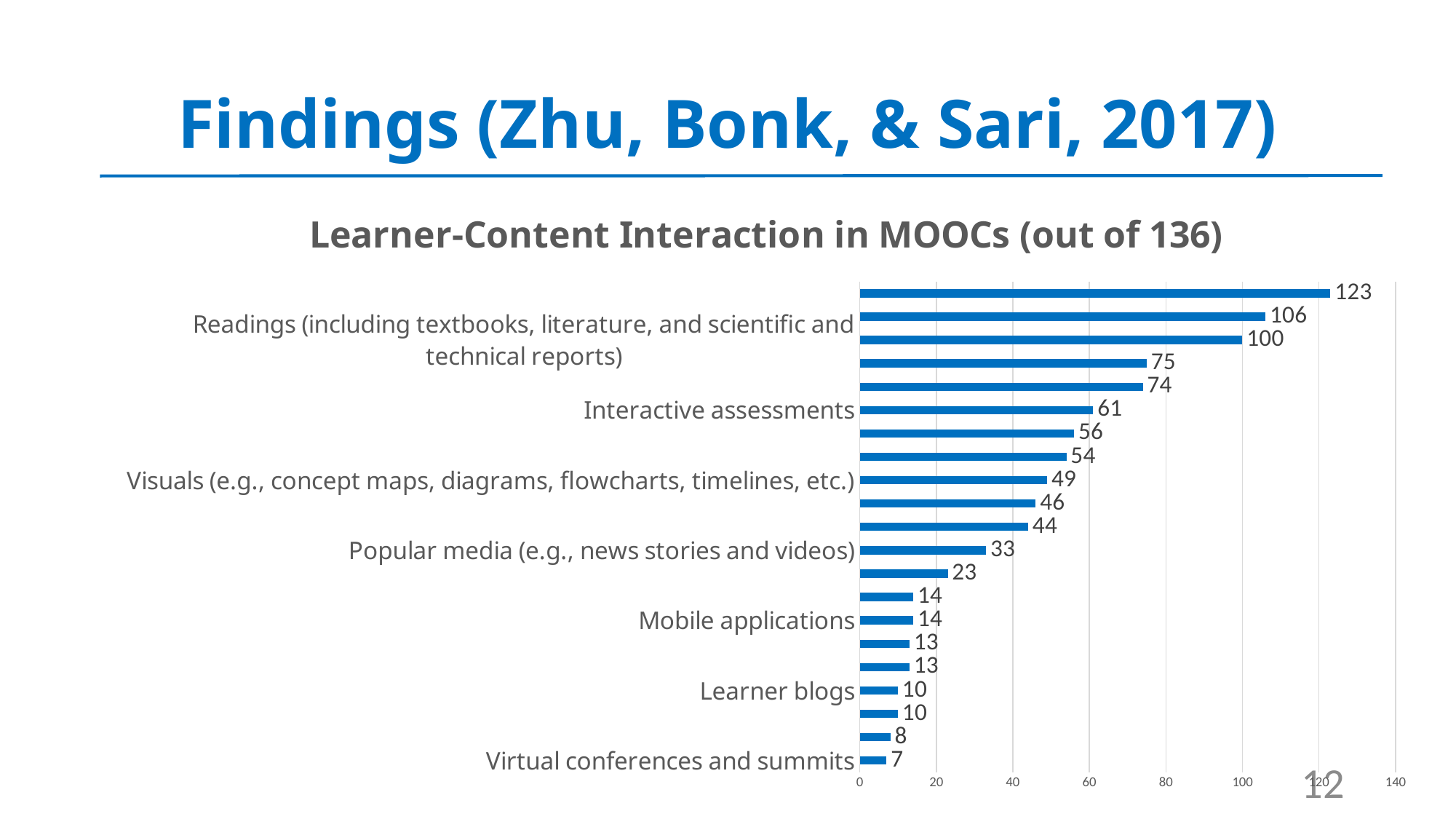
What is the difference between the values for Interactive assessments and Visuals (e.g., concept maps, diagrams, flowcharts, timelines, etc.)? 12 Is the value for Readings (including textbooks, literature, and scientific and technical reports) greater or less than 80? greater What is the highest value shown on the chart? 123 What is the value for Virtual conferences and summits? 7 What is the value for Popular media (e.g., news stories and videos)? 33 Which is larger, the value for Interactive assessments or the value for Popular media (e.g., news stories and videos)? Interactive assessments What is the value for Readings (including textbooks, literature, and scientific and technical reports)? 100 Which labeled category has the lowest value? Virtual conferences and summits What type of chart is shown on the slide? bar chart What is the title of the chart? Learner-Content Interaction in MOOCs (out of 136) What is the value for Visuals (e.g., concept maps, diagrams, flowcharts, timelines, etc.)? 49 What is the value for Interactive assessments? 61